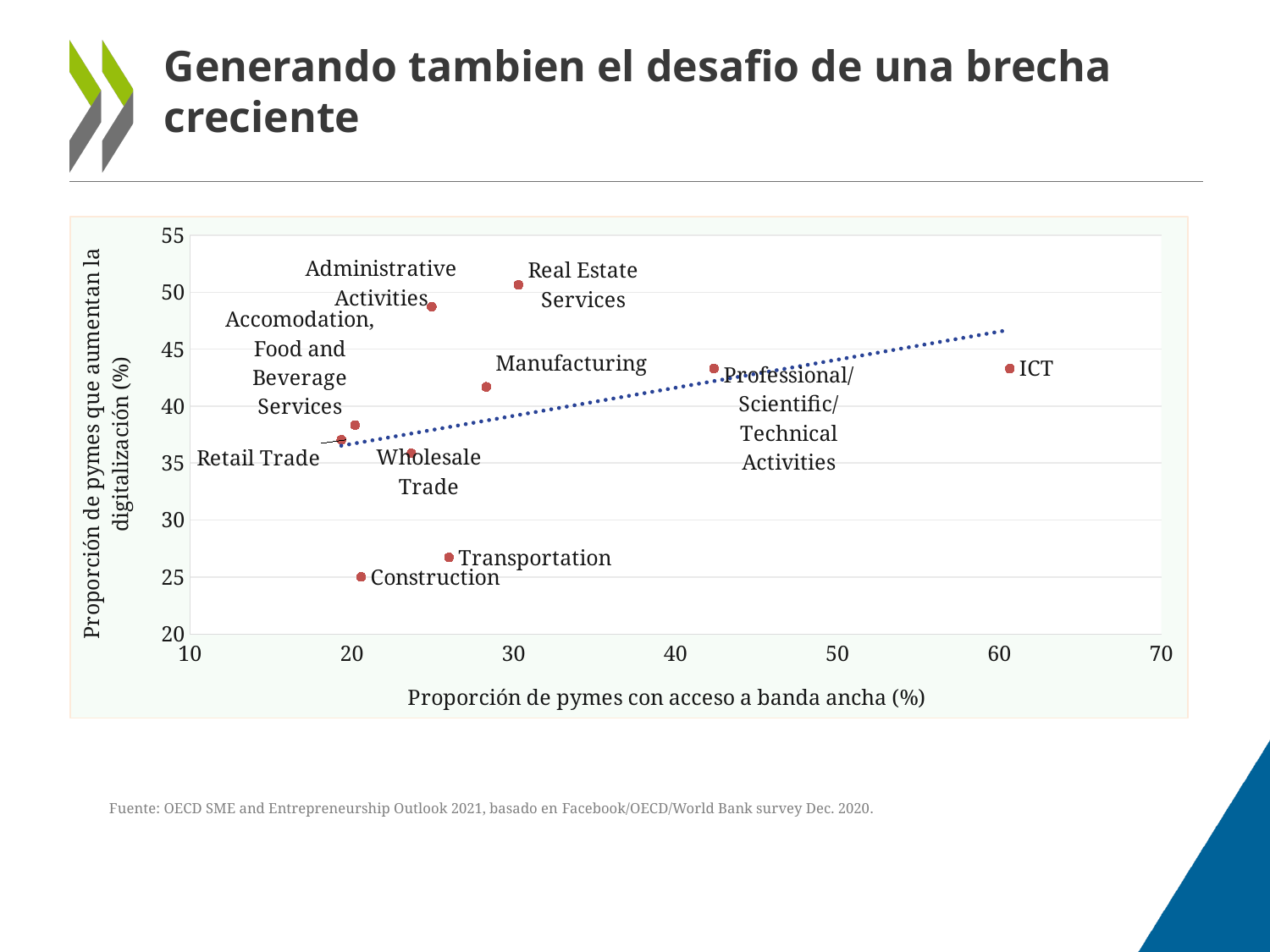
What kind of chart is shown on the slide? scatter chart Is the proportion of SMEs with broadband access for ICT greater or less than 50? greater What is the title of the x axis? Proporción de pymes con acceso a banda ancha (%) Which has a higher proportion of SMEs increasing digitalisation, Transportation or Manufacturing? Manufacturing Is the proportion of SMEs increasing digitalisation for Manufacturing greater or less than 40? greater Which sector has the highest proportion of SMEs increasing digitalisation (highest on the y axis)? Real Estate Services How many labelled data points are plotted on the chart? 10 According to the dotted trend line, does the proportion of SMEs increasing digitalisation rise or fall as broadband access increases? rise Is the proportion of SMEs increasing digitalisation for Real Estate Services greater or less than 50? greater Which sector has the highest proportion of SMEs with broadband access (furthest right on the x axis)? ICT Which sector has the lowest proportion of SMEs increasing digitalisation (lowest on the y axis)? Construction